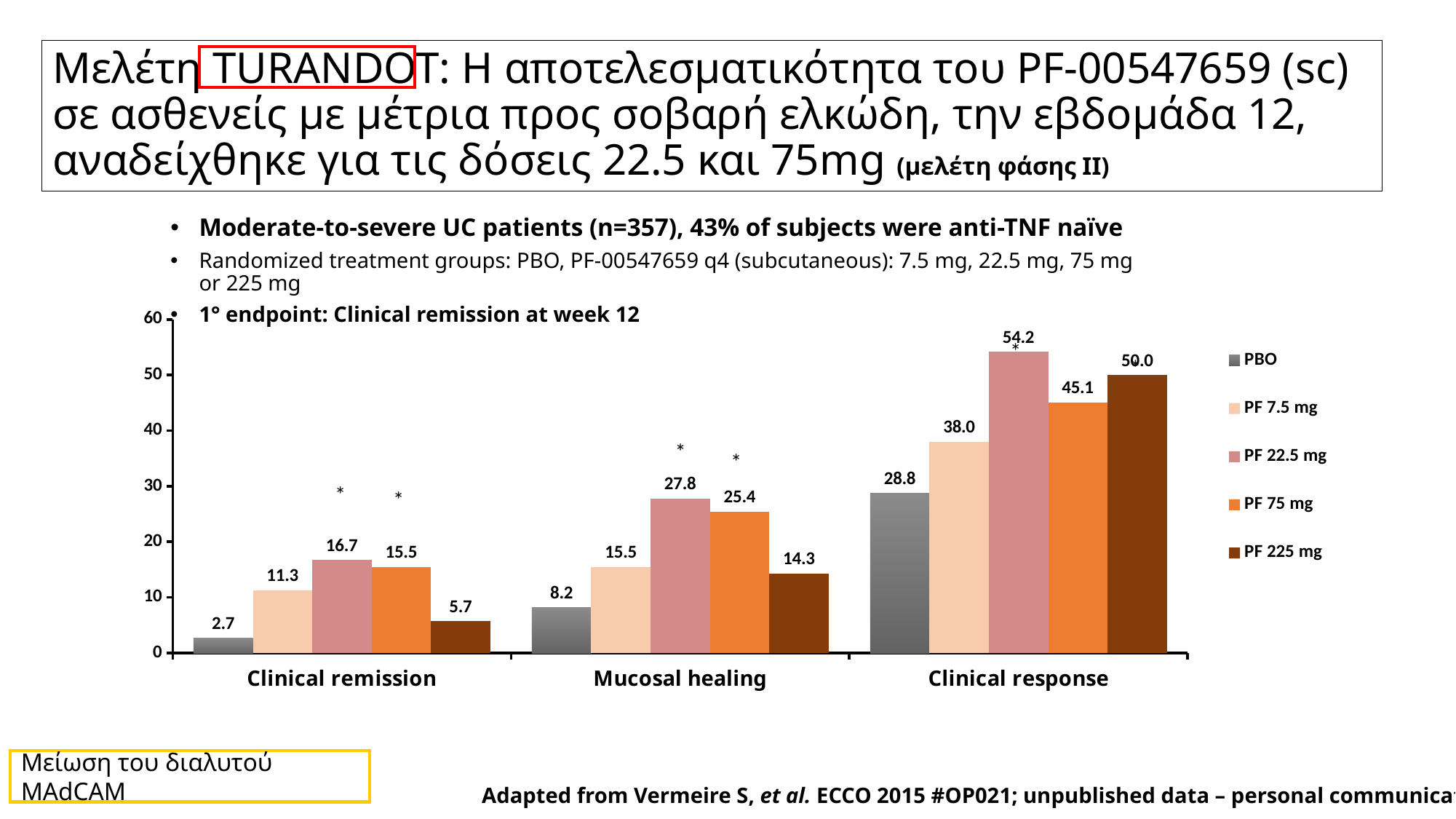
Which treatment group has the lowest value in the Clinical response category? PBO Is the value for PF 7.5 mg in the Clinical response category greater or less than 30? greater How many series does the legend list? 5 How many categories are shown on the x axis? 3 What is the label of the last series in the legend? PF 225 mg What is the value for PF 75 mg in the Mucosal healing category? 25.4 Which treatment group has the highest value in the Mucosal healing category? PF 22.5 mg What kind of chart is shown on the slide? bar chart What is the difference between the PF 22.5 mg and PBO values in the Clinical remission category? 14.0 What is the value for PF 22.5 mg in the Clinical response category? 54.2 In the Clinical response category, which is larger: PF 225 mg or PF 75 mg? PF 225 mg What is the value for PBO in the Clinical remission category? 2.7